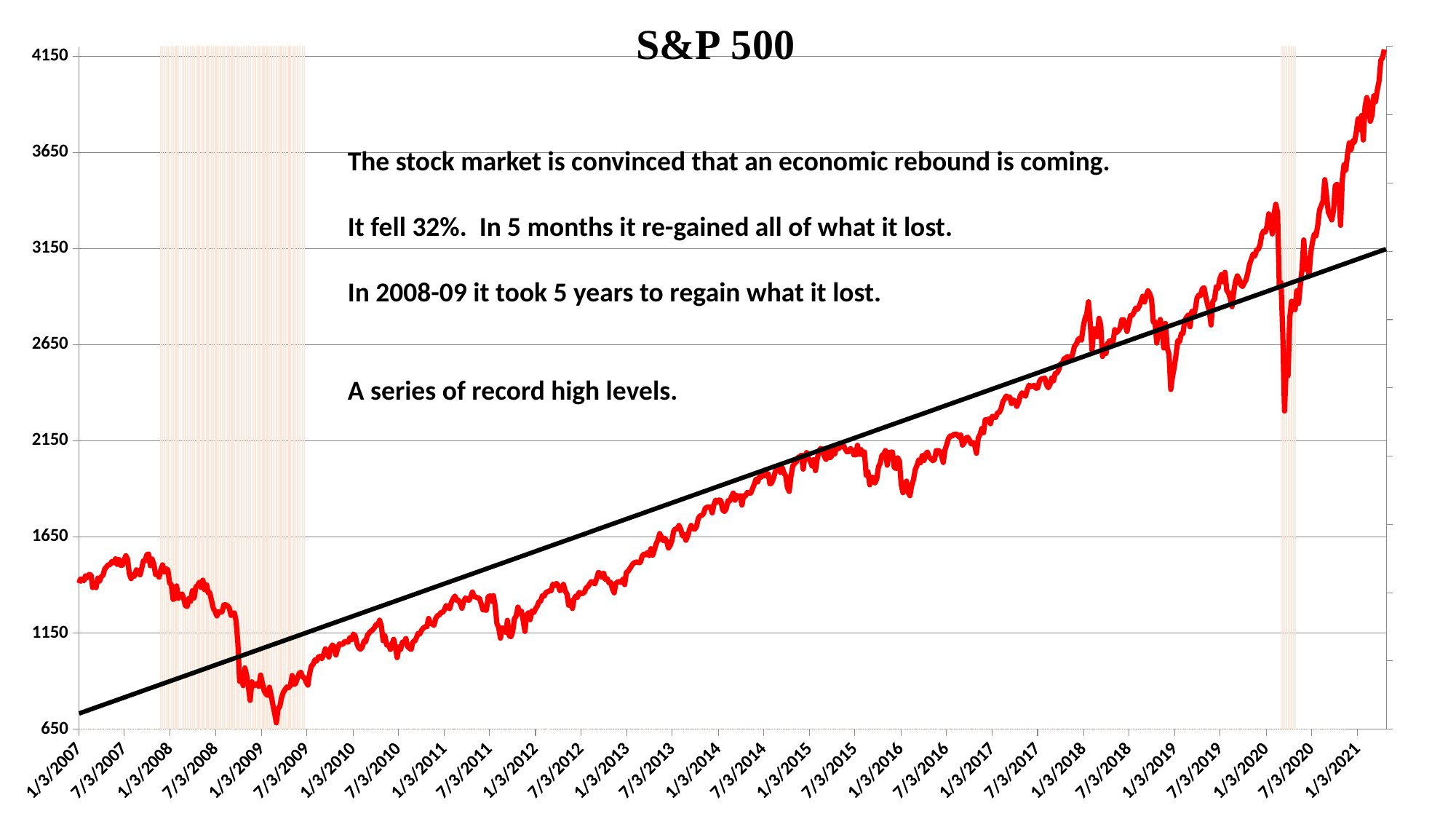
Overall, does the S&P 500 line rise or fall from 1/3/2007 to 1/3/2021? rise What kind of chart is shown on the slide? line chart Is the S&P 500 value at 1/3/2009 greater or less than 1150? less Is the S&P 500 value at 1/3/2007 greater or less than 1650? less What is the title of the chart? S&P 500 Is the S&P 500 value at 1/3/2016 greater or less than 2150? less How many date labels are shown on the x axis? 29 In which year does the S&P 500 line reach its lowest point? 2009 What colour is the plotted S&P 500 line? red Which is larger, the S&P 500 value at 1/3/2009 or at 1/3/2013? 1/3/2013